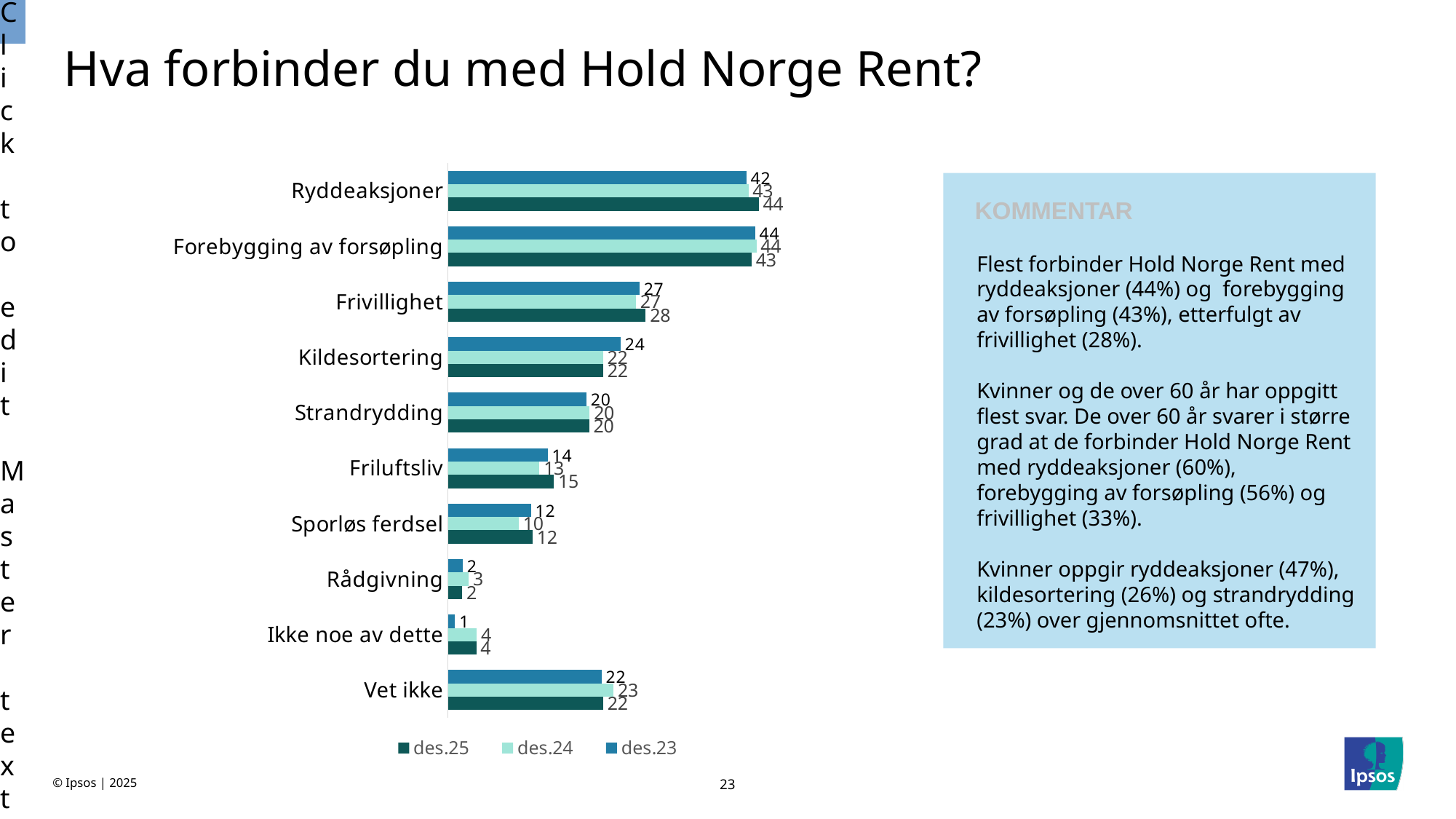
Which category has the lowest des.23 value? Ikke noe av dette How many categories are shown on the chart? 10 What is the title of the slide containing the chart? Hva forbinder du med Hold Norge Rent? What is the des.24 value for Sporløs ferdsel? 10 What is the difference between the des.25 values for Frivillighet and Friluftsliv? 13 What is the des.25 value for Ryddeaksjoner? 44 How many series does the legend list? 3 What kind of chart is shown on the slide? Bar chart Which category has the highest des.25 value? Ryddeaksjoner What is the des.23 value for Ikke noe av dette? 1 What is the des.23 value for Kildesortering? 24 Which is larger for Friluftsliv: the des.25 value or the des.24 value? des.25